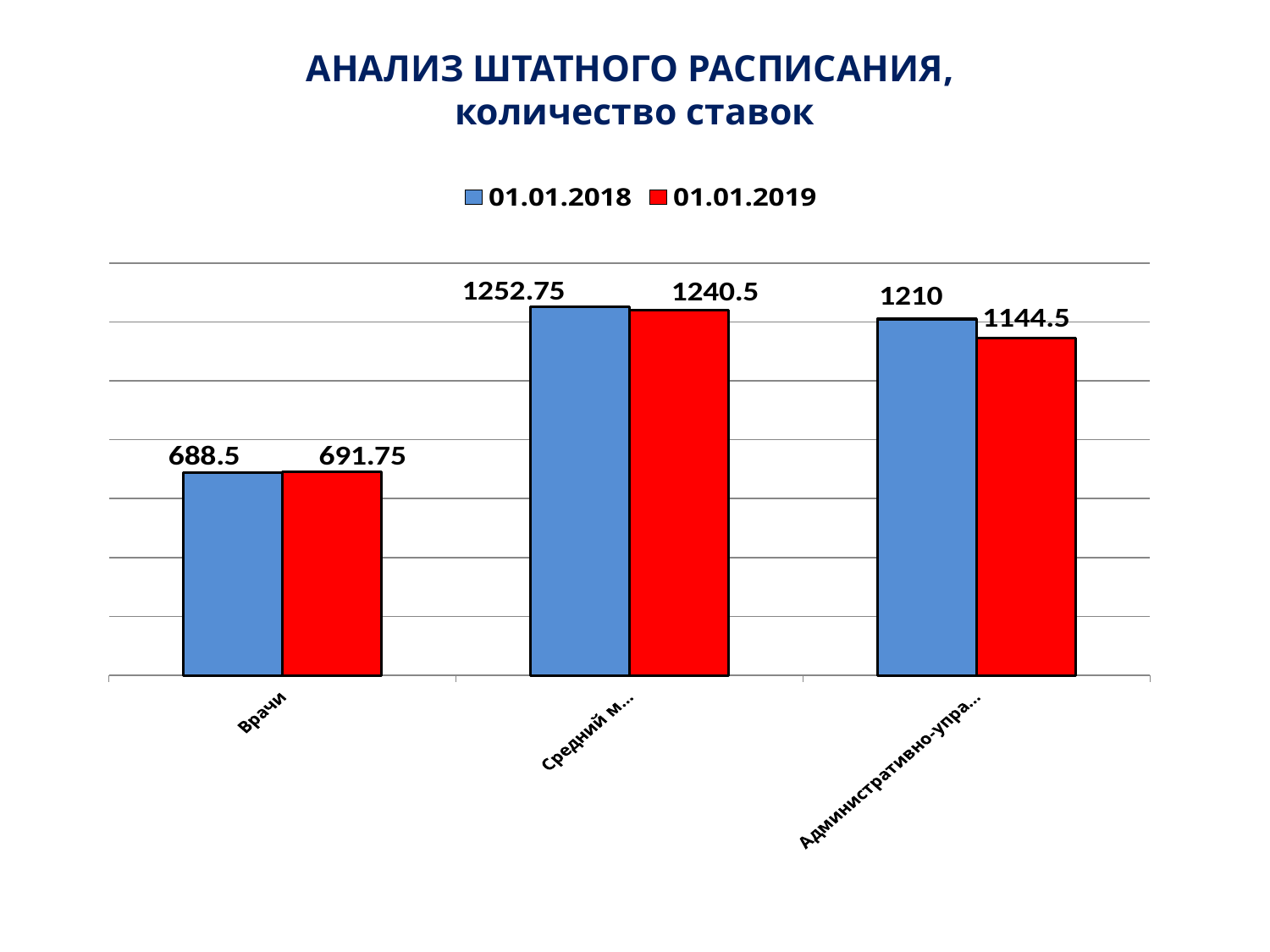
Which category has the lowest value in the 01.01.2019 series? Врачи What is the 01.01.2018 value for the middle category (label beginning 'Средний м')? 1252.75 What is the difference between the 01.01.2018 and 01.01.2019 values for the rightmost category (label beginning 'Административно-упра')? 65.5 What is the value for Врачи in the 01.01.2018 series? 688.5 Which category has the highest value in the 01.01.2018 series? Средний м... (the middle category) How many series does the legend list? 2 How many categories are shown on the x axis? 3 Which colour represents the 01.01.2019 series in the legend? Red What is the value for Врачи in the 01.01.2019 series? 691.75 What type of chart is shown on the slide? Bar chart What is the 01.01.2019 value for the rightmost category (label beginning 'Административно-упра')? 1144.5 For Врачи, which series has the larger value, 01.01.2018 or 01.01.2019? 01.01.2019